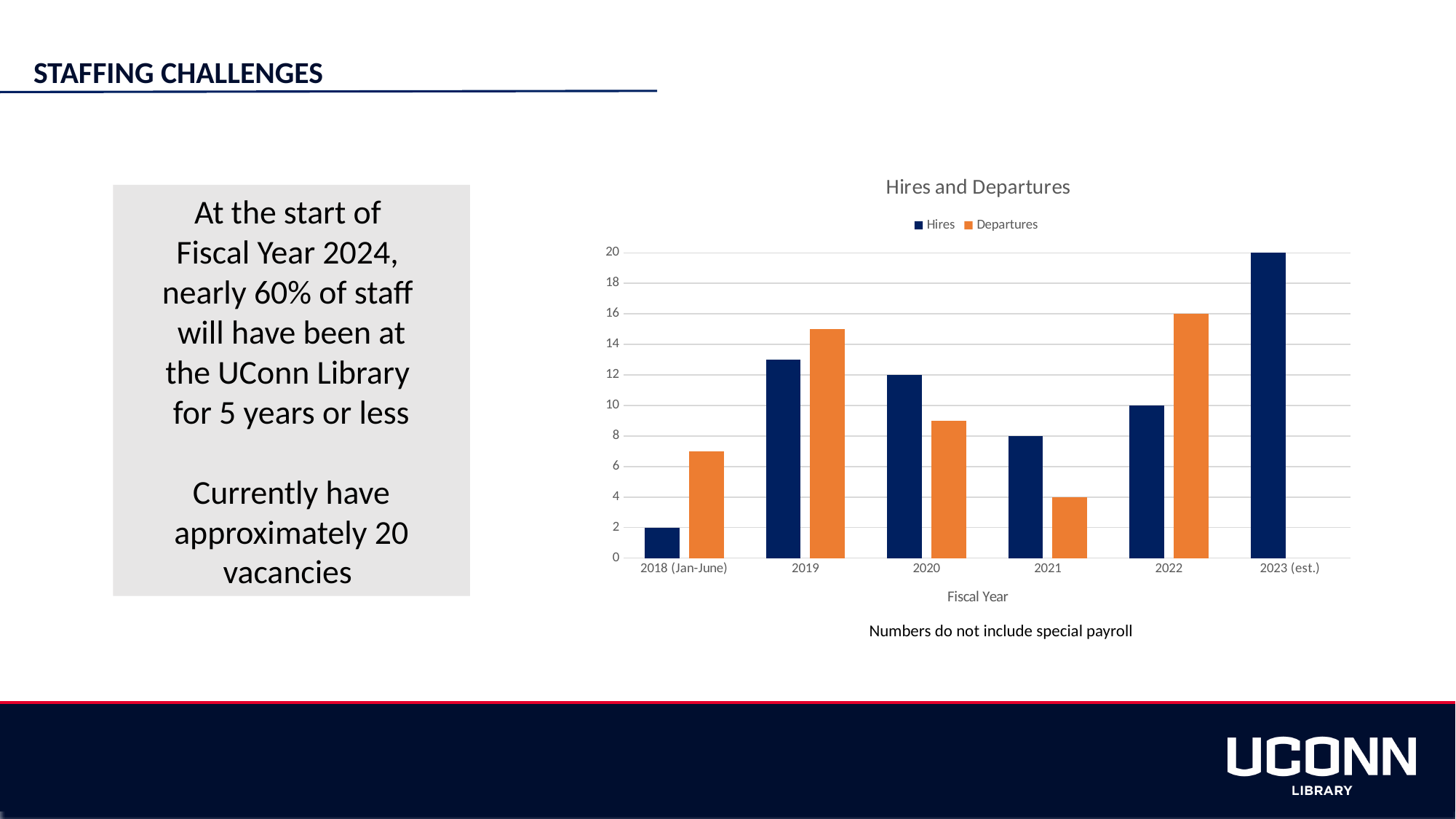
How many series does the chart legend list? 2 Which fiscal year has the lowest number of Hires? 2018 (Jan-June) What is the value of Hires for 2023 (est.)? 20 What is the value of Departures for 2022? 16 Is the value of Departures for 2019 greater or less than 14? greater Which fiscal year has the highest number of Departures? 2022 What is the difference between Departures and Hires in 2022? 6 What is the value of Hires for 2021? 8 What is the title of the chart? Hires and Departures In 2020, which is larger, Hires or Departures? Hires What type of chart is shown on the slide? bar chart How many fiscal year categories are shown on the x axis? 6